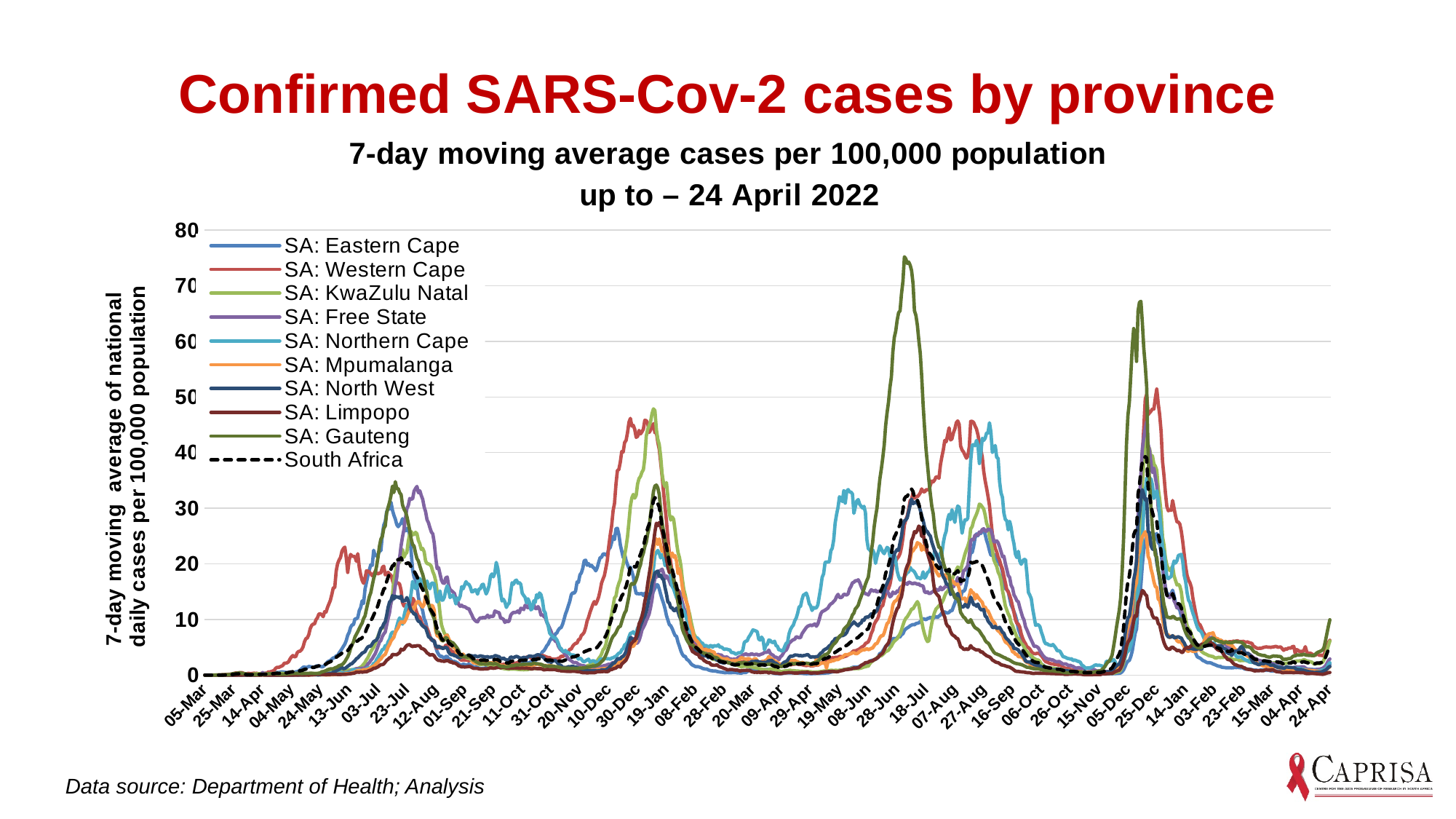
Is the peak value for SA: Gauteng around 28-Jun greater or less than 70? greater Is the peak value for SA: KwaZulu Natal around 19-Jan greater or less than 40? greater Is the peak value for SA: Western Cape around 25-Dec greater or less than 40? greater What type of chart is shown on the slide? line chart What is the title of the slide? Confirmed SARS-Cov-2 cases by province Which series reaches the highest peak on the chart? SA: Gauteng How many series does the legend list? 10 Which series is drawn as a dashed line? South Africa